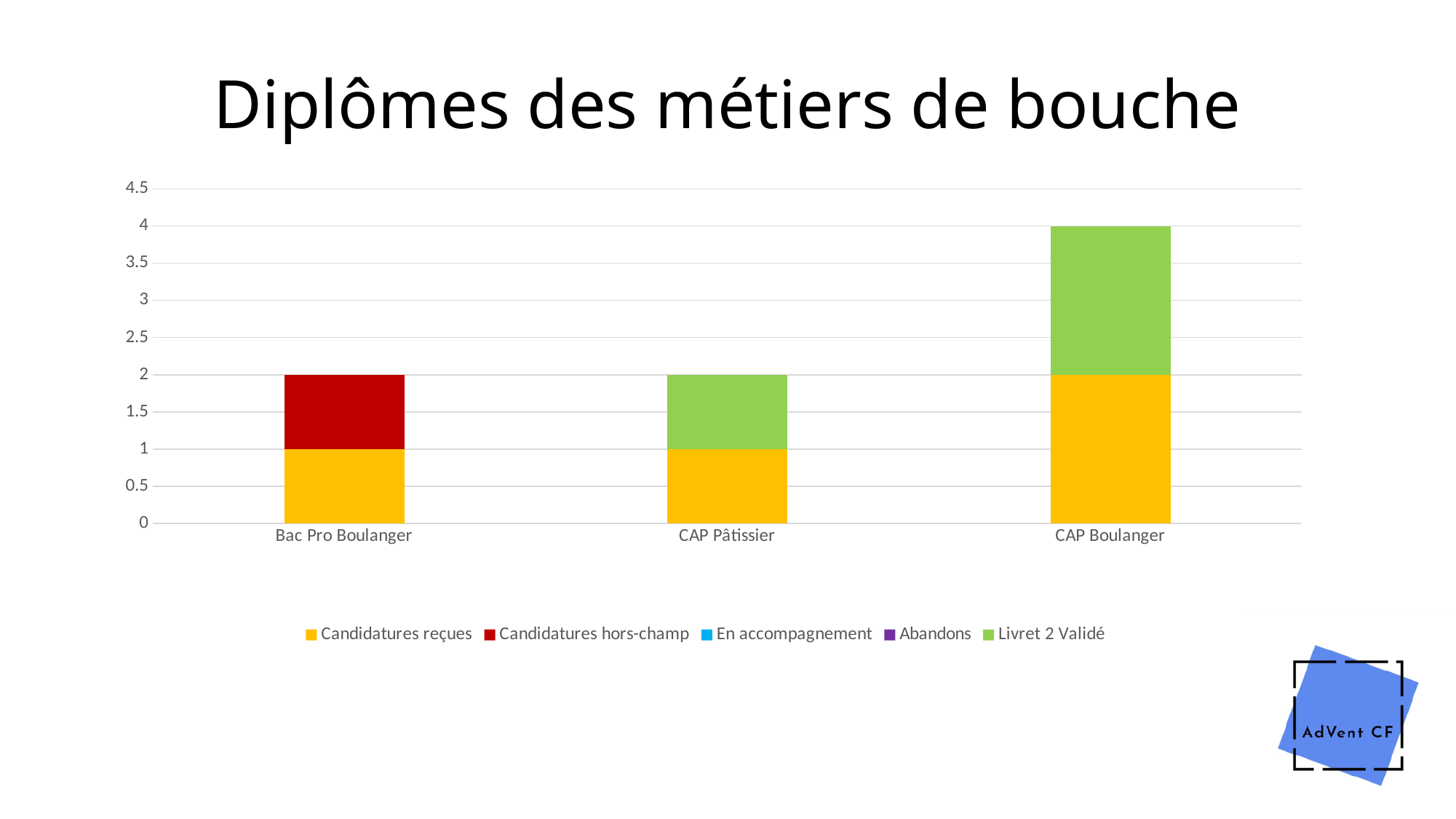
Which category has the highest total stacked bar? CAP Boulanger What is the value of Candidatures reçues for Bac Pro Boulanger? 1 What is the difference between the Livret 2 Validé value for CAP Boulanger and for CAP Pâtissier? 1 How many series does the legend list? 5 What is the value of Candidatures reçues for CAP Boulanger? 2 How many categories are shown on the x axis? 3 What kind of chart is shown on the slide? Stacked bar chart What is the title of the chart? Diplômes des métiers de bouche What is the total height of the stacked bar for Bac Pro Boulanger? 2 Which category is the only one with a Candidatures hors-champ segment? Bac Pro Boulanger What is the total height of the stacked bar for CAP Boulanger? 4 What is the value of Livret 2 Validé for CAP Pâtissier? 1